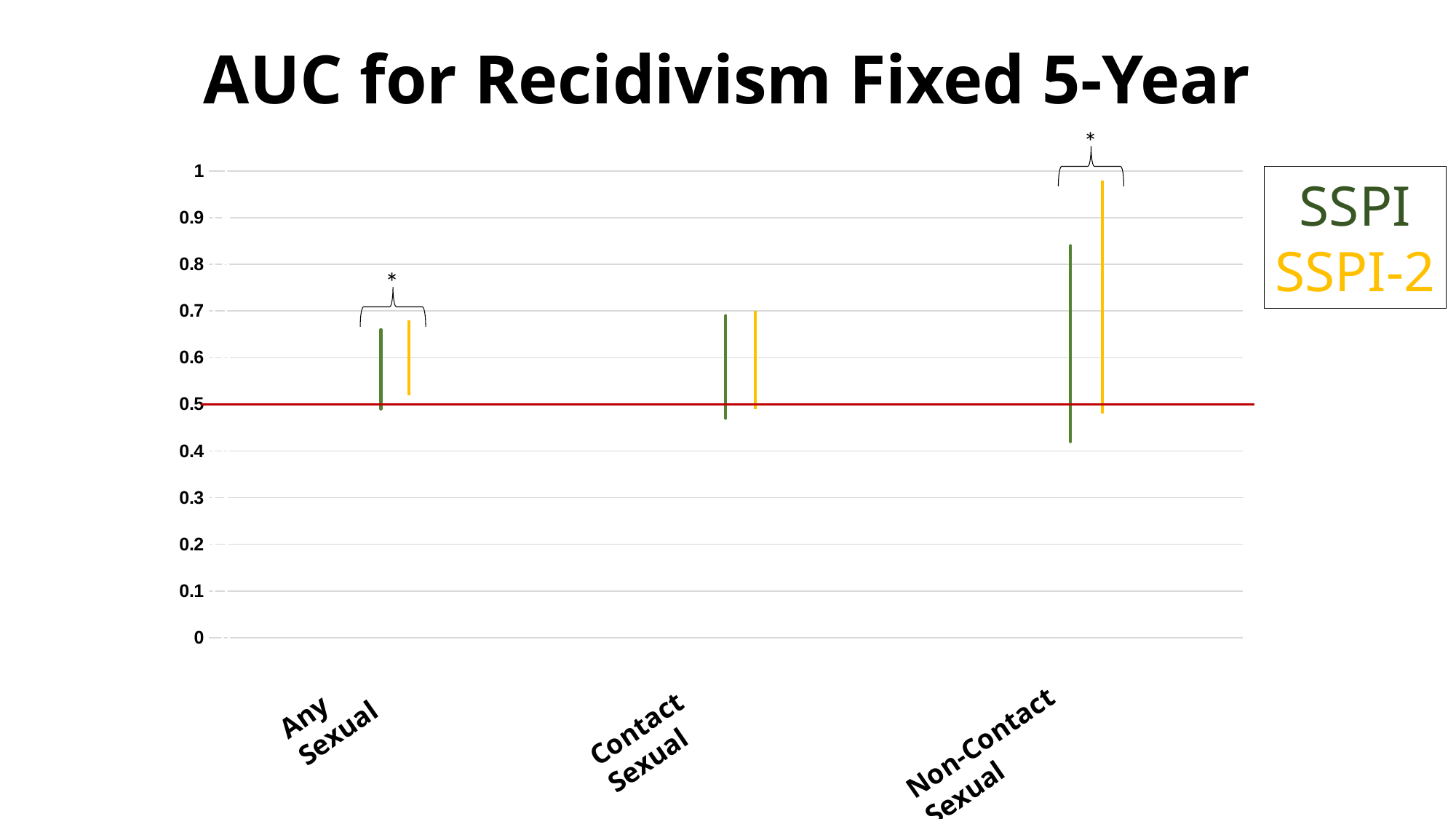
How many categories are shown on the x axis? 3 Is the upper end of the SSPI line for Any Sexual greater or less than 0.7? less At what value is the red horizontal reference line drawn? 0.5 What is the title of the chart? AUC for Recidivism Fixed 5-Year Which categories are marked with an asterisk above them? Any Sexual and Non-Contact Sexual What are the two series named in the legend? SSPI and SSPI-2 Which category has the SSPI-2 line reaching the highest value? Non-Contact Sexual What is the maximum value shown on the y axis? 1 How many series does the legend list? 2 Is the upper end of the SSPI-2 line for Non-Contact Sexual greater or less than 0.9? greater Is the lower end of the SSPI line for Non-Contact Sexual greater or less than 0.5? less